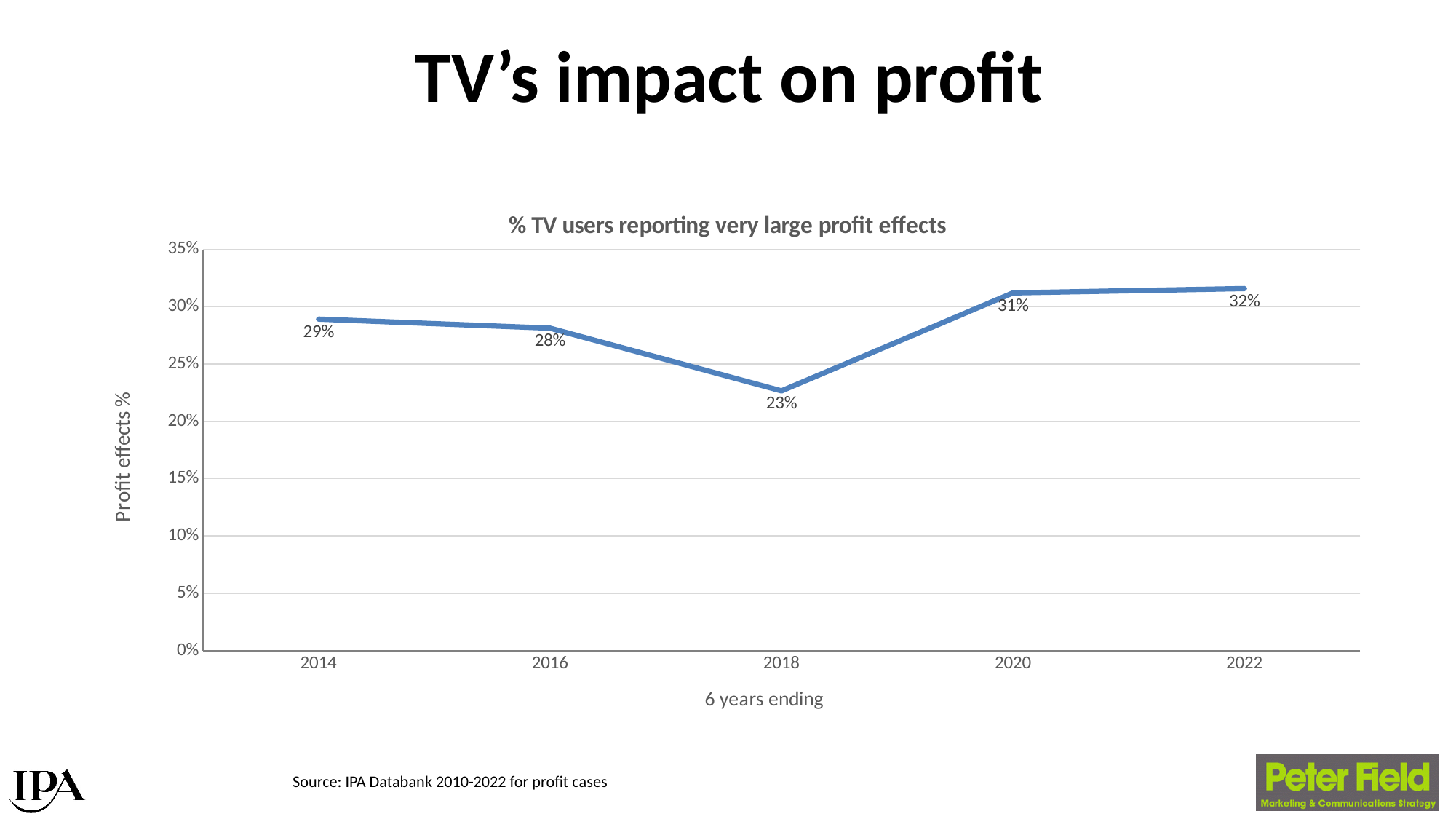
What is the value for 2014? 29% What is the difference between the values for 2020 and 2018? 8% Do the values rise or fall from 2018 to 2022? rise What kind of chart is shown? line chart Which year has the lowest value? 2018 Which is larger, the value for 2016 or the value for 2020? 2020 Is the value for 2018 greater or less than 25%? less How many years are plotted on the chart? 5 What is the value for 2018? 23% Which year has the highest value? 2022 What is the value for 2022? 32% What is the title of the chart? % TV users reporting very large profit effects